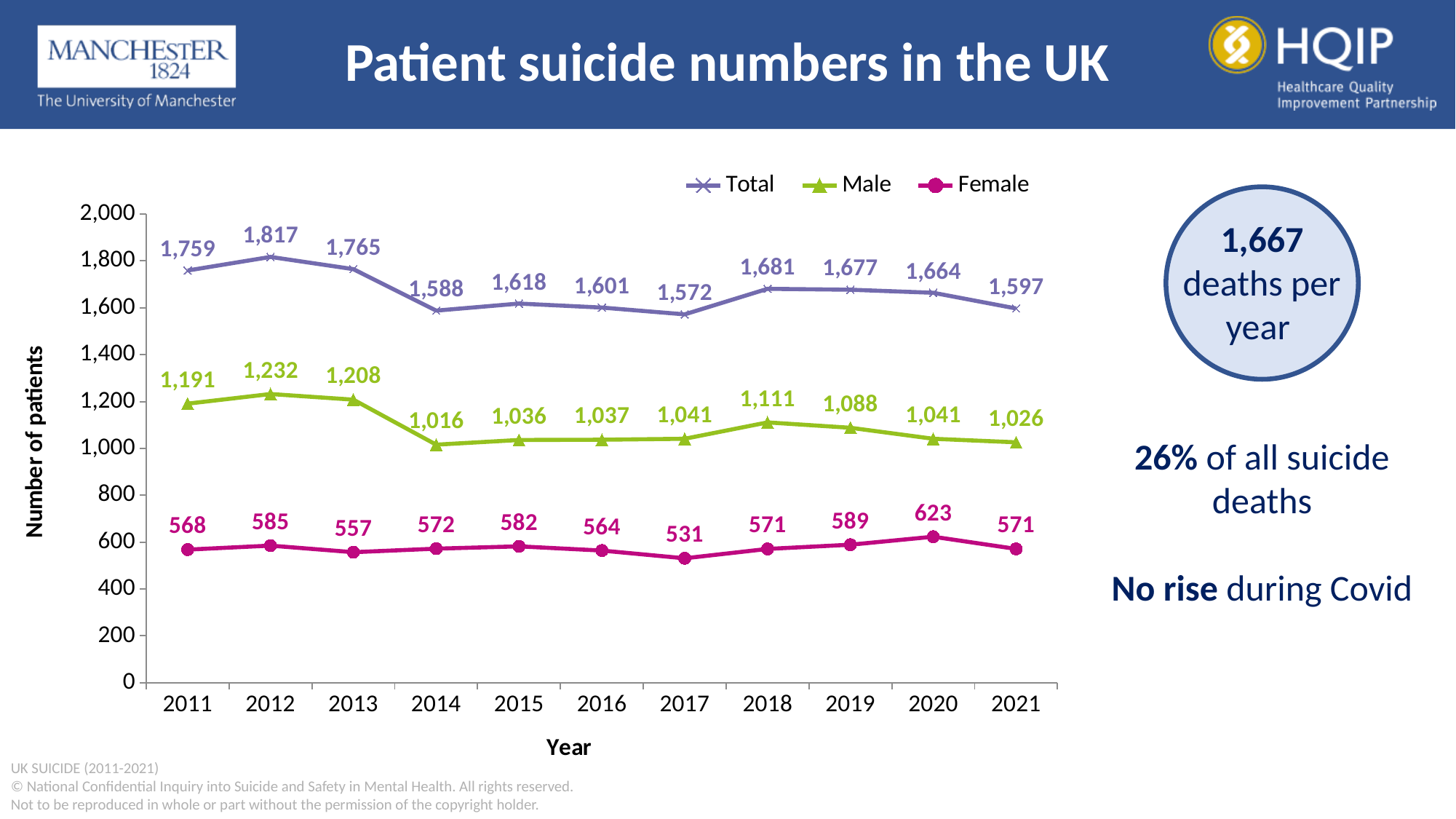
What is the Male value for 2014? 1,016 What is the Female value for 2020? 623 What is the difference between the Male and Female values in 2021? 455 In which year is the Total series highest? 2012 How many years are shown on the x axis? 11 Which is larger, the Total value for 2018 or the Total value for 2019? 2018 Is the Male value for 2013 greater or less than 1,200? greater What kind of chart is shown on the slide? Line chart What is the Total value for 2012? 1,817 In which year is the Female series lowest? 2017 How many series does the legend list? 3 What is the title of the chart? Patient suicide numbers in the UK